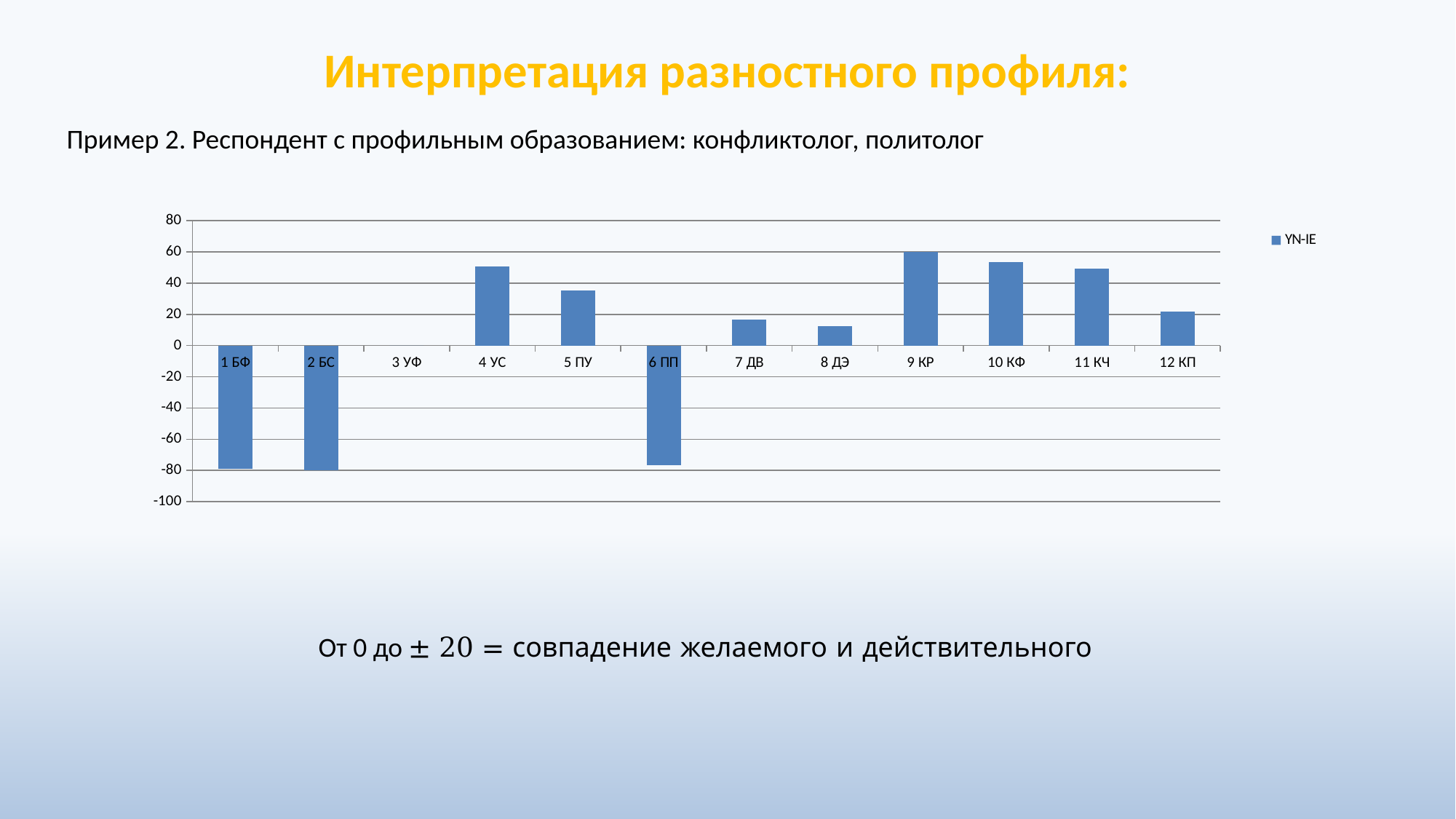
Is the value for 4 УС greater or less than 40? greater Which has the larger value, 11 КЧ or 12 КП? 11 КЧ Which has the larger value, 4 УС or 7 ДВ? 4 УС What is the name of the series shown in the chart legend? YN-IE Is the value for 5 ПУ greater or less than 40? less Which has the larger value, 9 КР or 5 ПУ? 9 КР How many categories are shown on the x axis of the chart? 12 What kind of chart is shown on the slide? bar chart Is the value for 6 ПП greater or less than -60? less How many series does the chart legend list? 1 Which category has the highest value in the chart? 9 КР